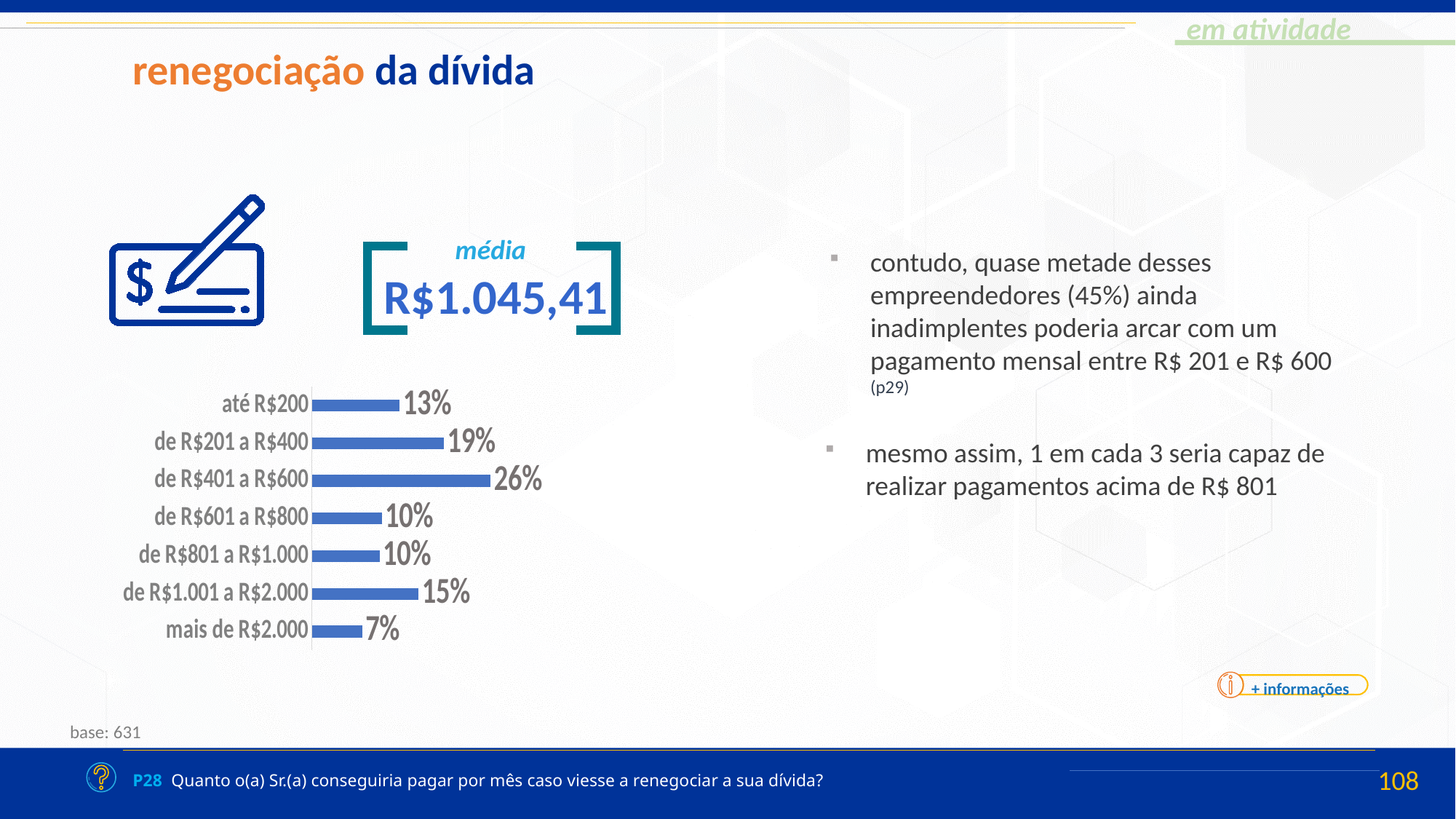
What is the value for the category 'de R$401 a R$600'? 26% Which category has the lowest value? mais de R$2.000 What is the value for the category 'de R$1.001 a R$2.000'? 15% What is the value for the category 'até R$200'? 13% What kind of chart is shown on the slide? bar chart What is the base (number of respondents) shown on the slide? 631 How many categories does the bar chart show? 7 What is the value for the category 'mais de R$2.000'? 7% What is the average (média) value shown on the slide? R$1.045,41 Which is larger: the value for 'de R$1.001 a R$2.000' or the value for 'de R$601 a R$800'? de R$1.001 a R$2.000 What is the difference between the values for 'de R$401 a R$600' and 'de R$201 a R$400'? 7% Which category has the highest value? de R$401 a R$600